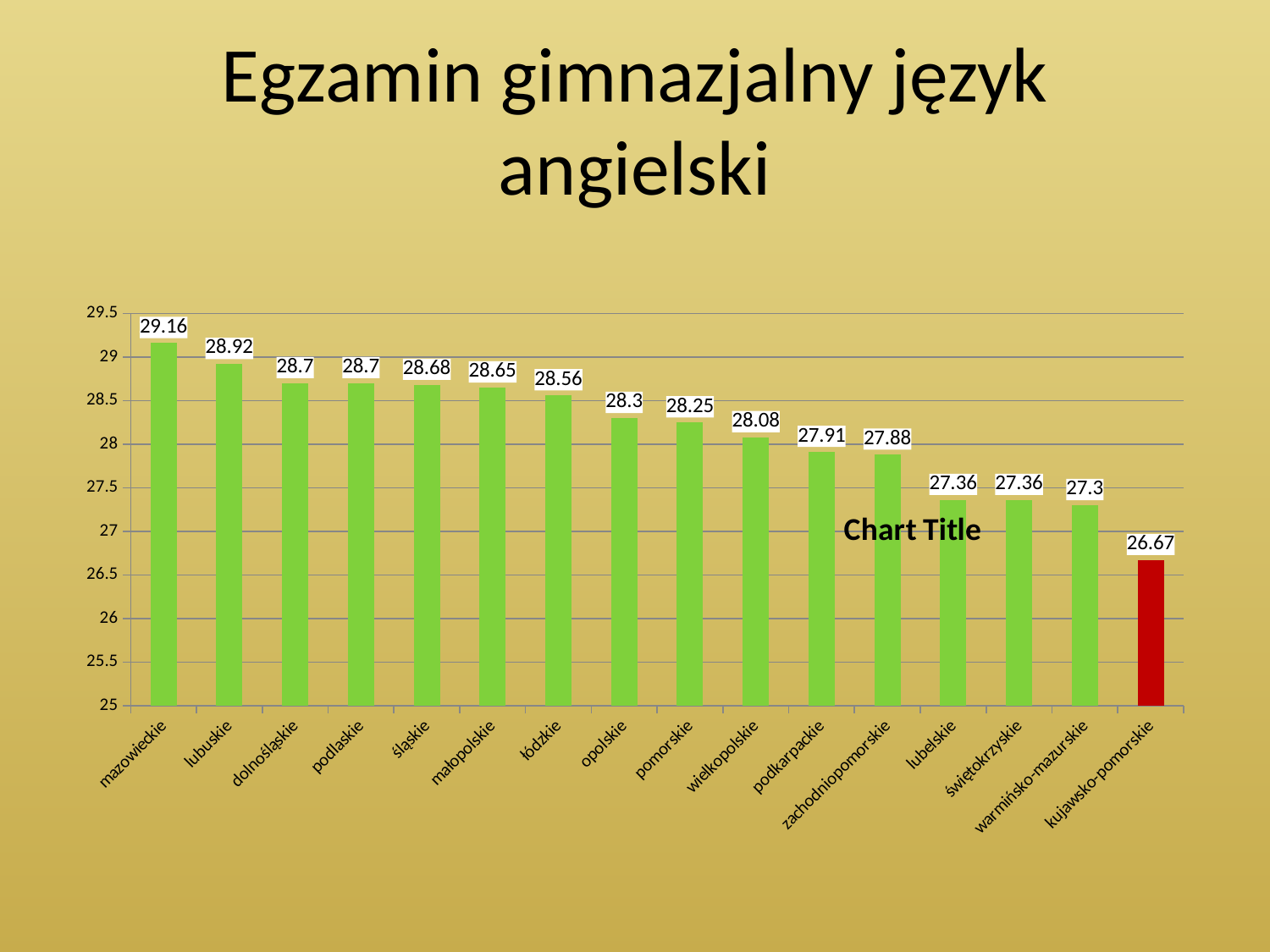
Do the values rise or fall from left to right along the x axis? fall Which category has the highest value? mazowieckie Which is larger, the value for lubuskie or the value for pomorskie? lubuskie Which bar is shown in a different colour (red) from the others? kujawsko-pomorskie What is the value for mazowieckie? 29.16 Which category has the lowest value? kujawsko-pomorskie What is the value for kujawsko-pomorskie? 26.67 How many categories are shown on the x axis? 16 Is the value for wielkopolskie greater or less than 28? greater What kind of chart is shown on the slide? bar chart What is the value for opolskie? 28.3 What is the difference between the values for mazowieckie and kujawsko-pomorskie? 2.49